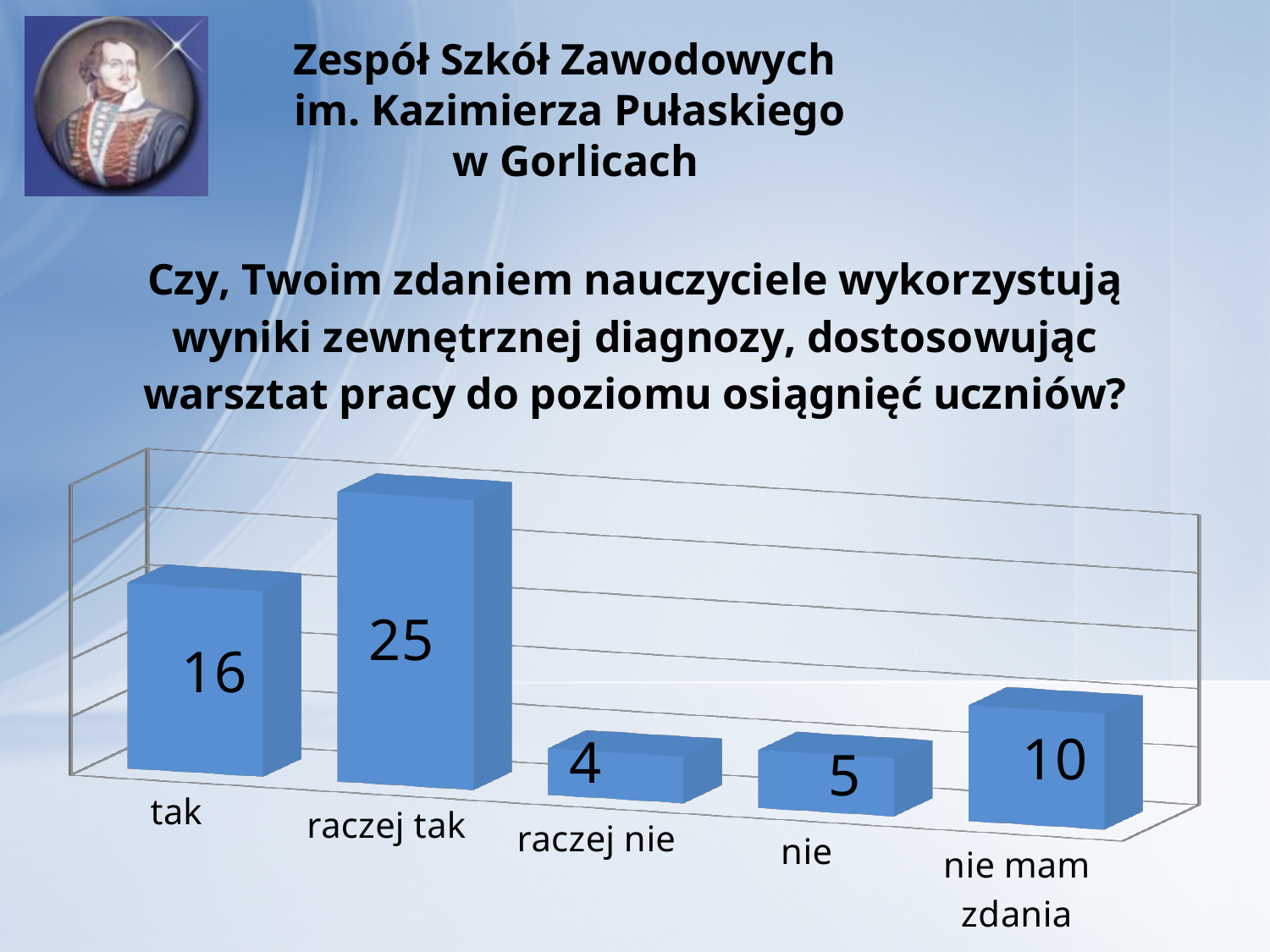
What is the difference between the values for "nie mam zdania" and "nie"? 5 What is the value for "raczej tak"? 25 What is the difference between the values for "raczej tak" and "tak"? 9 What is the value for "nie mam zdania"? 10 Which is larger, the value for "tak" or the value for "nie mam zdania"? tak Which category has the lowest value? raczej nie What is the value for "tak"? 16 Which category has the highest value? raczej tak What is the value for "raczej nie"? 4 What kind of chart is shown on the slide? bar chart What is the total of all the values shown in the chart? 60 How many categories are shown in the chart? 5